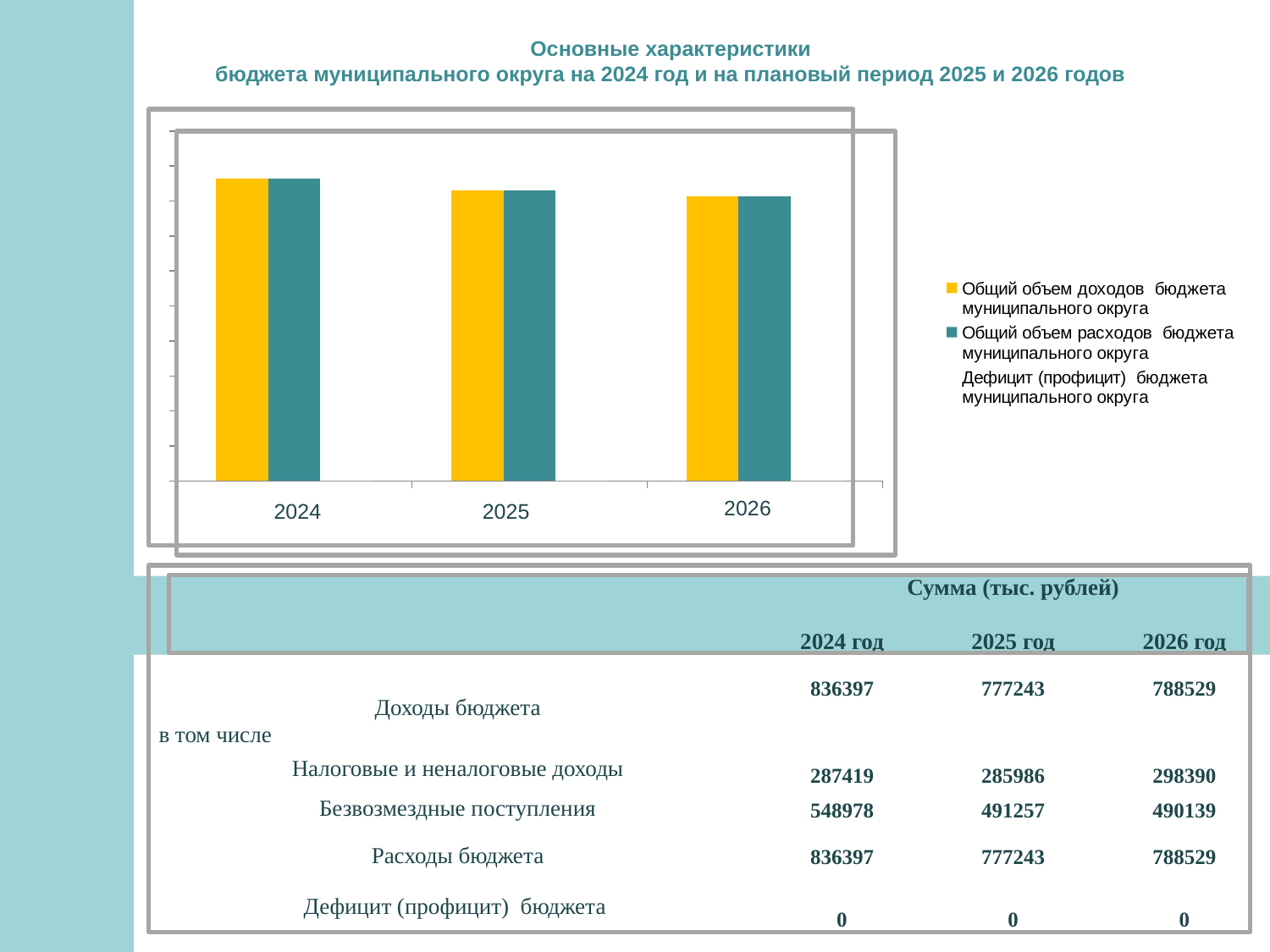
How many years (categories) are shown on the x axis of the chart? 3 What kind of chart is shown on the slide? bar chart According to the slide, what is the value of 'Доходы бюджета' for 2024 (тыс. рублей)? 836397 According to the slide, what is the value of 'Расходы бюджета' for 2026 (тыс. рублей)? 788529 Which year has the tallest bar for 'Общий объем доходов бюджета муниципального округа'? 2024 How many series does the chart legend list? 3 Which is larger in the chart: the income bar for 2024 or the income bar for 2026? 2024 Does the bar for 'Общий объем доходов бюджета муниципального округа' rise or fall from 2024 to 2025? fall What colour are the bars for 'Общий объем доходов бюджета муниципального округа'? yellow Which legend entry is shown in teal (dark green-blue)? Общий объем расходов бюджета муниципального округа According to the slide, what is the value of 'Дефицит (профицит) бюджета' for 2025? 0 Which year has the tallest bar for 'Общий объем расходов бюджета муниципального округа'? 2024